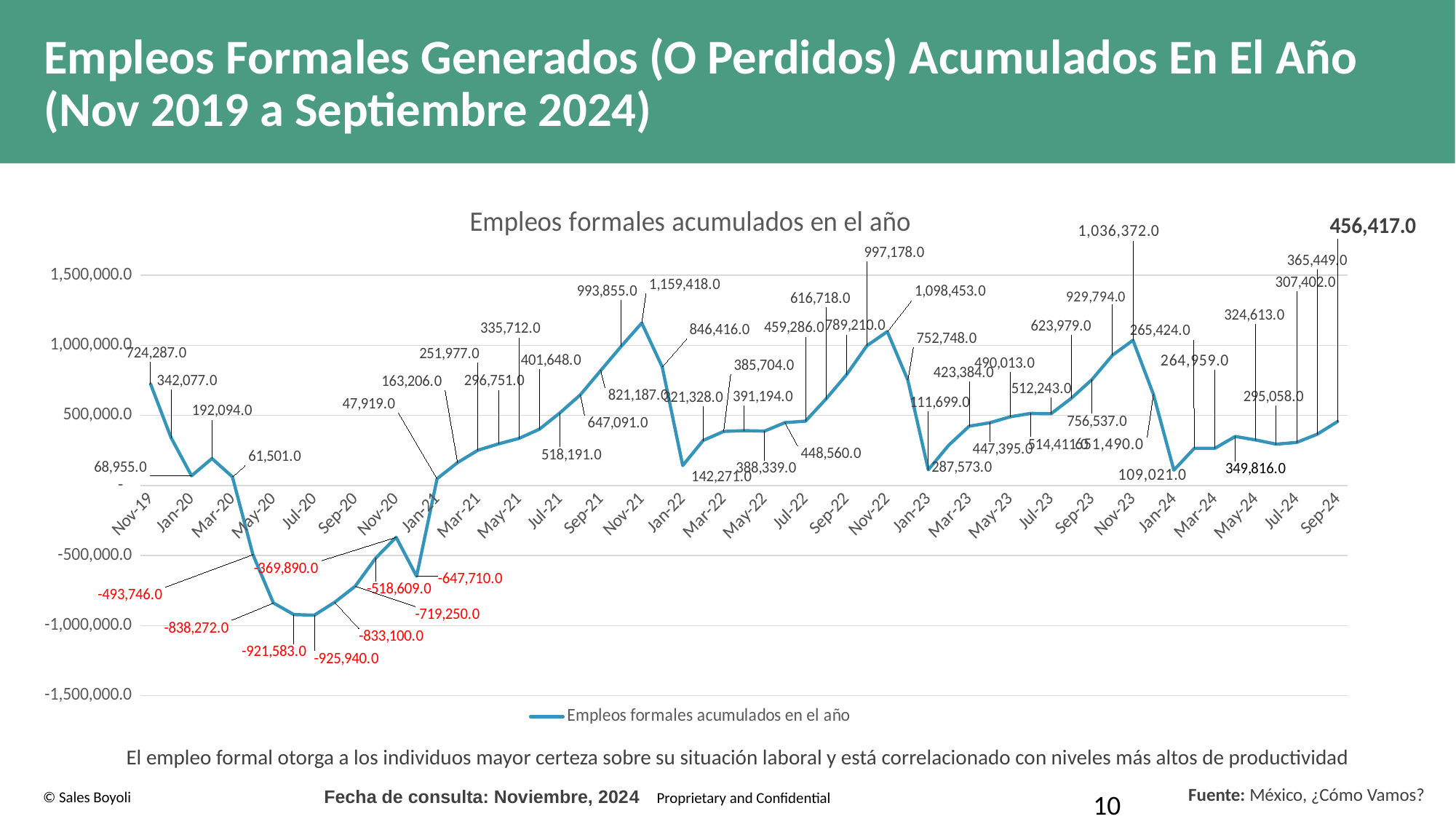
Is the value for Nov-22 greater or less than 1,000,000? greater What is the value for Sep-24? 456,417.0 What is the value for Nov-19? 724,287.0 Which is larger, the value for Nov-19 or the value for Sep-24? Nov-19 What is the value for Jan-20? 68,955.0 Which month has the highest value on the chart? Nov-21 Is the value for Jul-20 greater or less than -500,000? less What is the difference between the value for Nov-19 and the value for Sep-24? 267,870.0 What is the highest value shown on the chart? 1,159,418.0 What type of chart is shown on the slide? line chart How many series does the legend list? 1 What is the legend entry shown below the chart? Empleos formales acumulados en el año